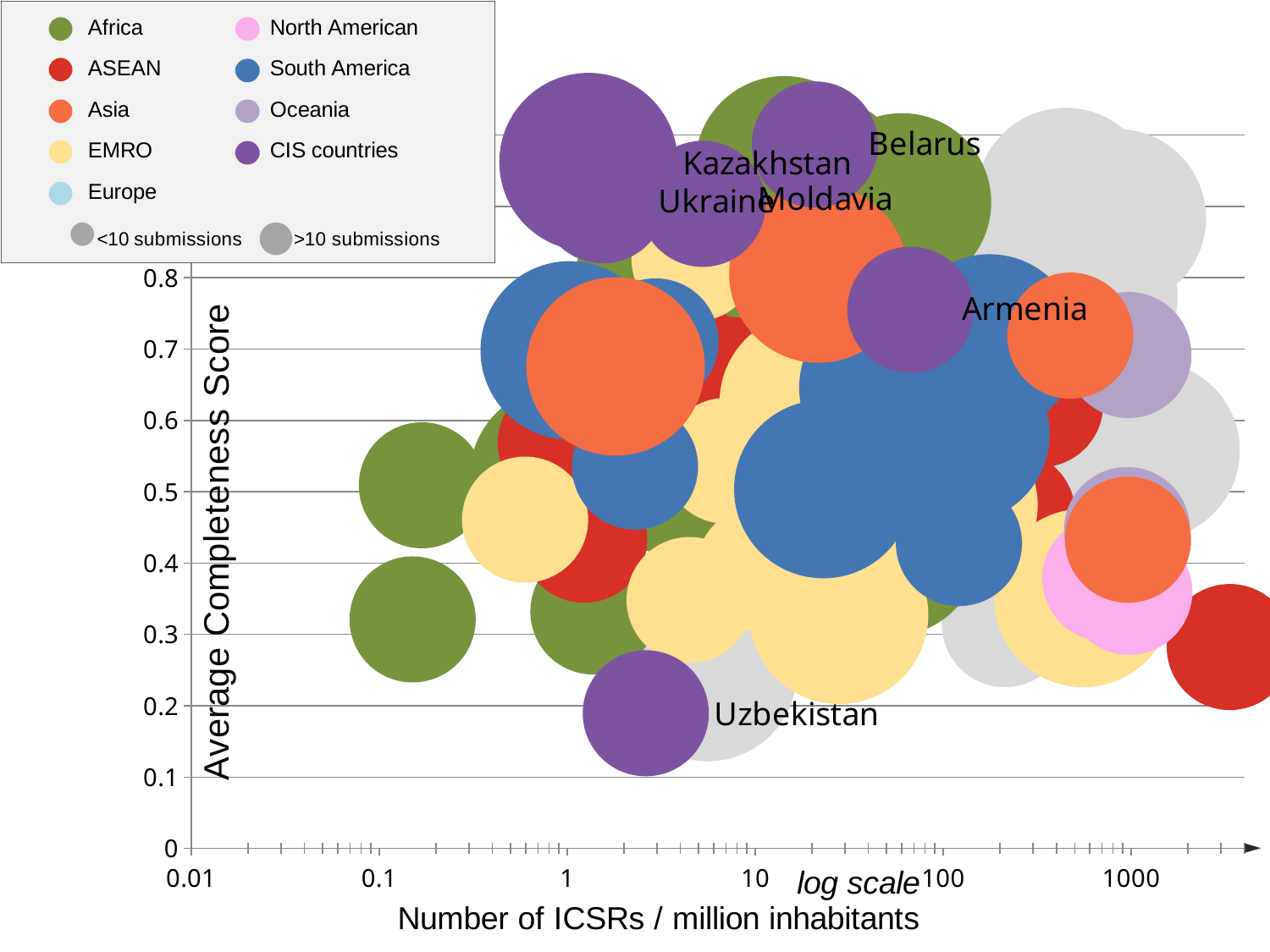
Which has the higher Number of ICSRs / million inhabitants, Belarus or Uzbekistan? Belarus Is the Average Completeness Score for Armenia greater or less than 0.6? greater What is the label of the x axis? Number of ICSRs / million inhabitants Is the Average Completeness Score for Uzbekistan greater or less than 0.3? less What is the label of the y axis? Average Completeness Score Among the labelled countries, which has the lowest Average Completeness Score? Uzbekistan How many regions does the legend list? 9 Is the Average Completeness Score for Belarus greater or less than 0.8? greater What kind of chart is shown on the slide? bubble chart Which has the higher Average Completeness Score, Armenia or Uzbekistan? Armenia How many countries are labelled by name on the chart? 6